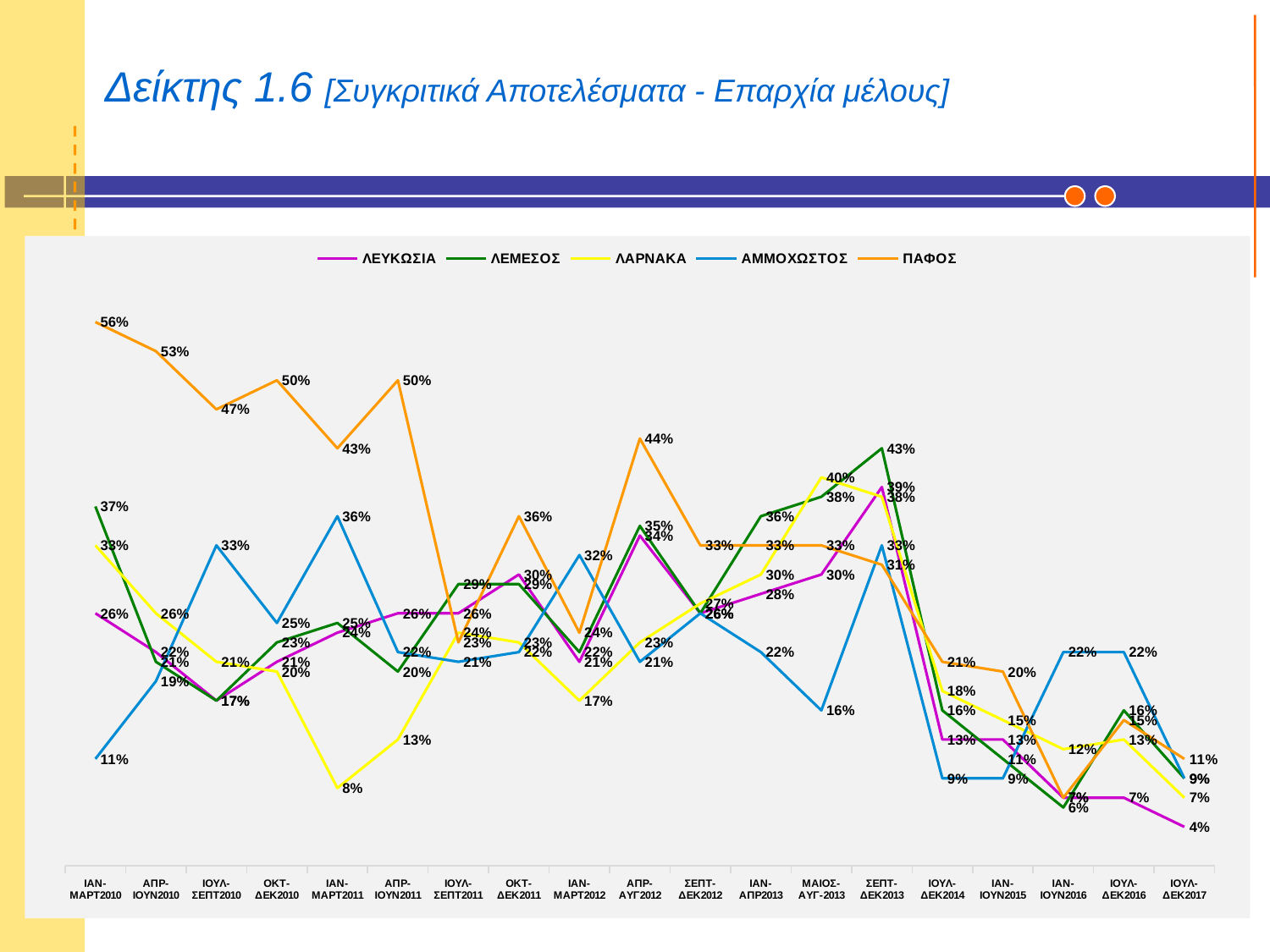
What kind of chart is shown on the slide? Line chart In ΙΑΝ-ΜΑΡΤ2011, which is larger: ΑΜΜΟΧΩΣΤΟΣ or ΛΑΡΝΑΚΑ? ΑΜΜΟΧΩΣΤΟΣ What is the value for ΛΑΡΝΑΚΑ in ΙΑΝ-ΜΑΡΤ2011? 8% What is the difference between ΠΑΦΟΣ and ΑΜΜΟΧΩΣΤΟΣ in ΙΑΝ-ΜΑΡΤ2010? 45 percentage points How many time periods are shown on the x axis? 19 What is the value for ΠΑΦΟΣ in ΙΑΝ-ΜΑΡΤ2010? 56% Which series has the highest value in ΙΑΝ-ΜΑΡΤ2010? ΠΑΦΟΣ Which series has the lowest value in ΙΟΥΛ-ΔΕΚ2017? ΛΕΥΚΩΣΙΑ What is the value for ΛΕΥΚΩΣΙΑ in ΙΟΥΛ-ΔΕΚ2017? 4% What is the value for ΛΕΜΕΣΟΣ in ΣΕΠΤ-ΔΕΚ2013? 43% What is the value for ΑΜΜΟΧΩΣΤΟΣ in ΜΑΙΟΣ-ΑΥΓ-2013? 16% How many series does the legend list? 5